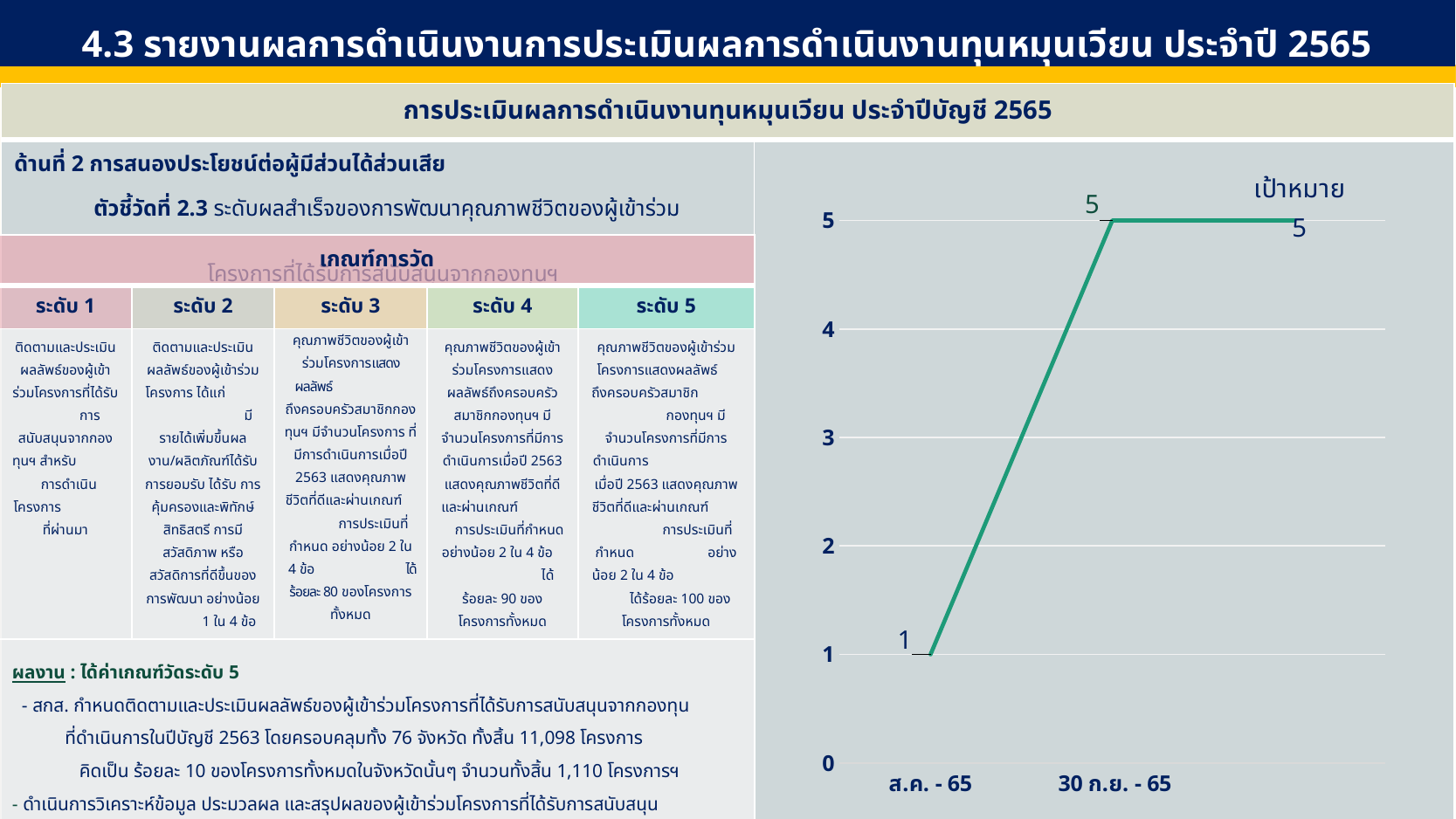
Which point on the line has the lowest value? ส.ค. - 65 What colour is the line in the chart? green What is the value plotted for ส.ค. - 65? 1 Which is larger, the value for ส.ค. - 65 or the value for 30 ก.ย. - 65? 30 ก.ย. - 65 What kind of chart is shown on the right side of the slide? line chart What is the highest value shown on the y axis? 5 What is the value plotted for 30 ก.ย. - 65? 5 Is the value for ส.ค. - 65 greater or less than 2? less Does the line rise or fall from ส.ค. - 65 to 30 ก.ย. - 65? rise What is the difference between the value for 30 ก.ย. - 65 and the value for ส.ค. - 65? 4 How many data points are plotted on the line? 3 What is the value shown for เป้าหมาย? 5